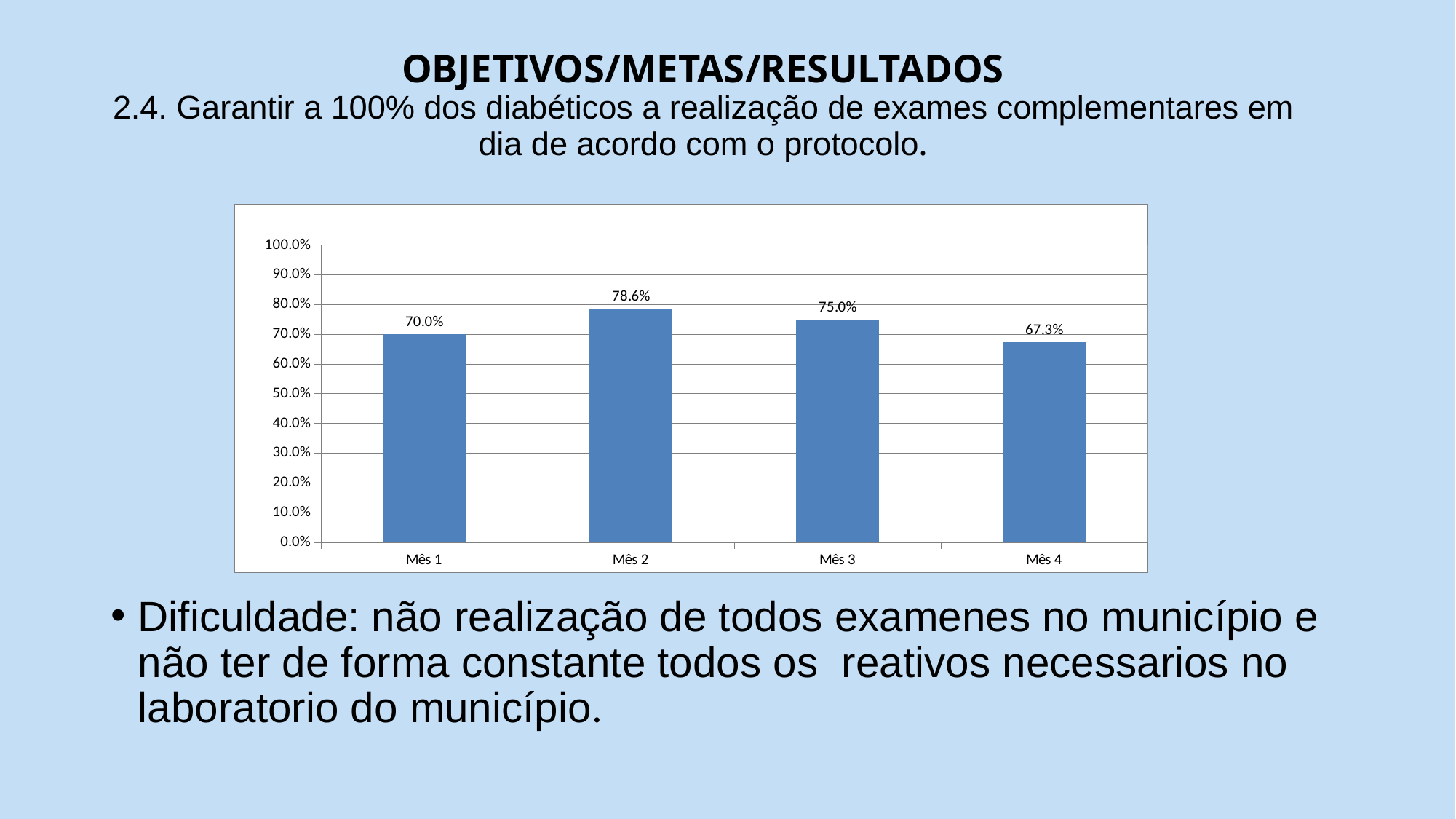
What is the value for Mês 1? 70.0% Which month has the lowest value? Mês 4 What kind of chart is shown on the slide? bar chart What is the difference between the values for Mês 2 and Mês 4? 11.3% Which month has the highest value? Mês 2 What is the value for Mês 2? 78.6% Is the value for Mês 4 greater or less than 70.0%? less What is the value for Mês 3? 75.0% What is the value for Mês 4? 67.3% Which is larger, the value for Mês 1 or the value for Mês 3? Mês 3 Do the values rise or fall from Mês 2 to Mês 4? fall How many months are shown on the x axis? 4